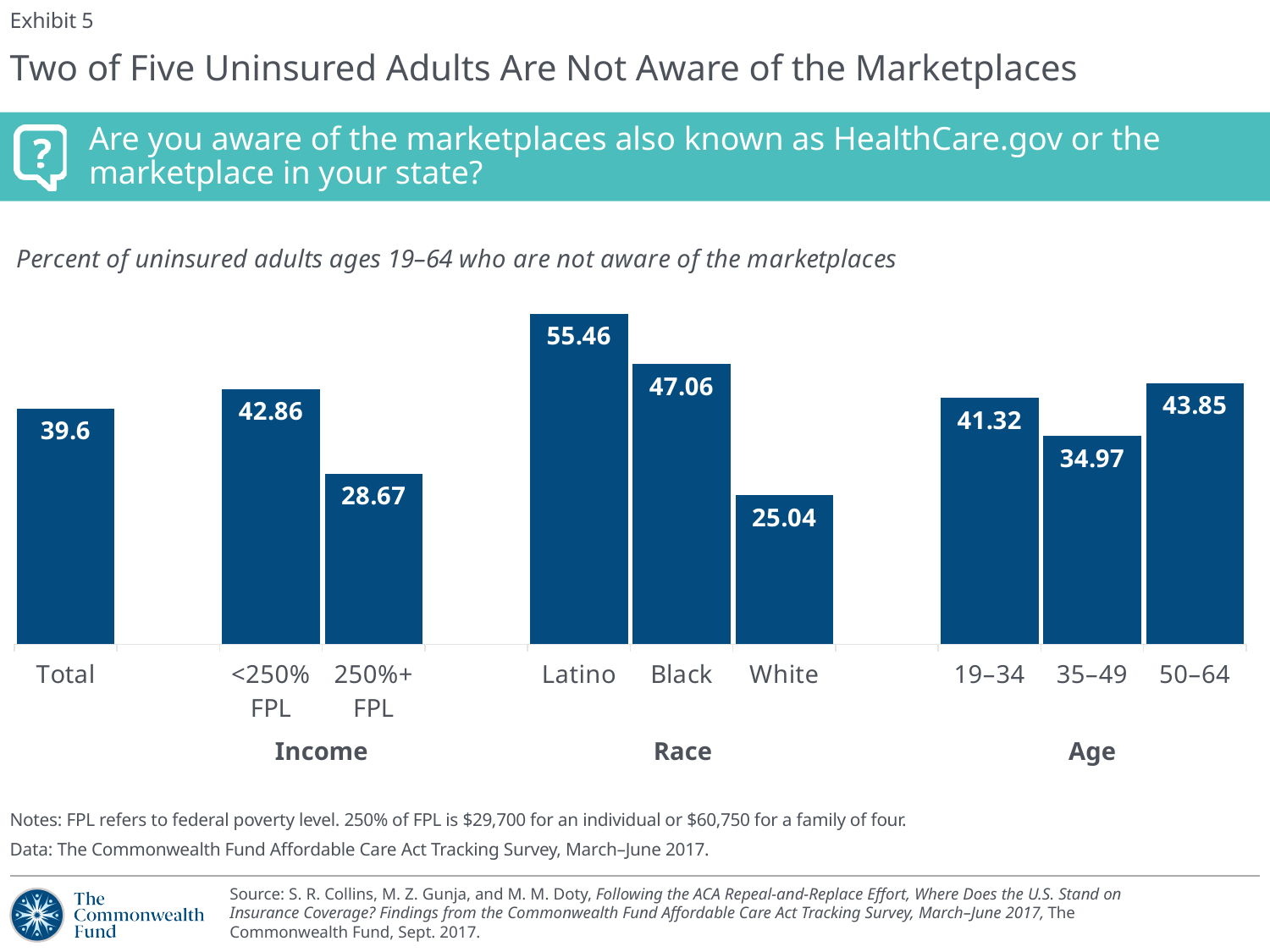
What are the three group labels shown beneath the category axis? Income, Race, Age How many bars are shown in the chart? 9 What is the value for ages 35–49? 34.97 What kind of chart is this? Bar chart Which is larger, the value for 50–64 or the value for 19–34? 50–64 Which category has the highest value? Latino What is the difference between the values for <250% FPL and 250%+ FPL? 14.19 What is the value for Total? 39.6 What is the value for 250%+ FPL? 28.67 What is the value for Latino? 55.46 What is the difference between the values for Latino and White? 30.42 Which category has the lowest value? White